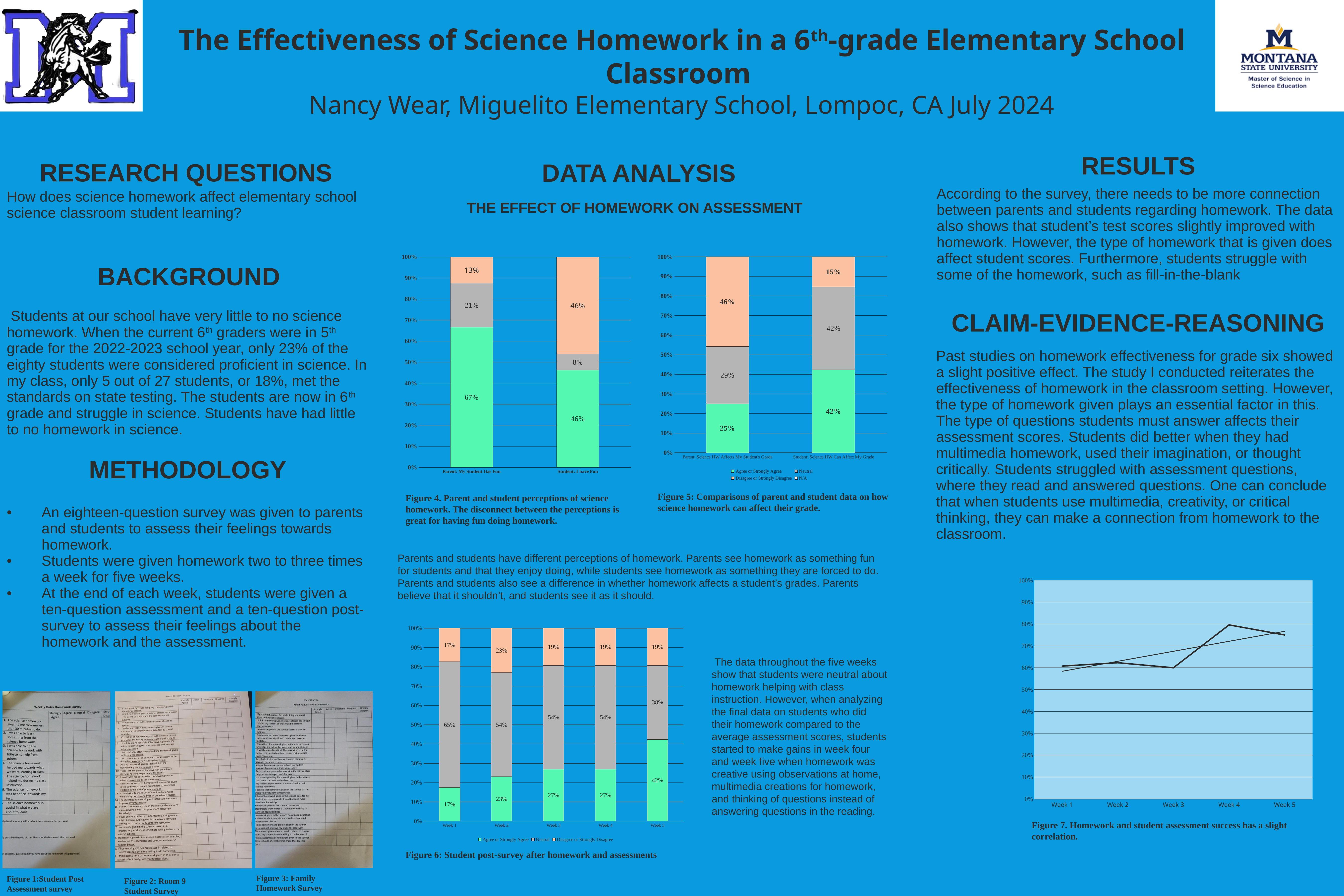
In Figure 5, what percentage of students agree or strongly agree that science homework can affect their grade? 42% In Figure 4, what percentage is shown for the green (bottom) segment of the 'Parent: My Student Has Fun' bar? 67% In Figure 6, which week has the highest 'Agree or Strongly Agree' percentage? Week 5 In Figure 6, is the 'Agree or Strongly Agree' value for Week 2 larger or smaller than the value for Week 5? smaller In Figure 5, how many entries does the legend list? 4 In Figure 5, what percentage of parents disagree or strongly disagree that science homework affects their student's grade? 46% In Figure 4, what percentage is shown for the top (orange) segment of the 'Student: I have Fun' bar? 46% In Figure 6, how many weeks are shown on the x axis? 5 In Figure 7, do the plotted values generally rise or fall from Week 1 to Week 5? rise In Figure 4, what is the difference between the green segment of the 'Parent: My Student Has Fun' bar (67%) and the green segment of the 'Student: I have Fun' bar (46%)? 21% What kind of chart is Figure 7? line chart In Figure 6, what is the 'Neutral' percentage for Week 1? 65%